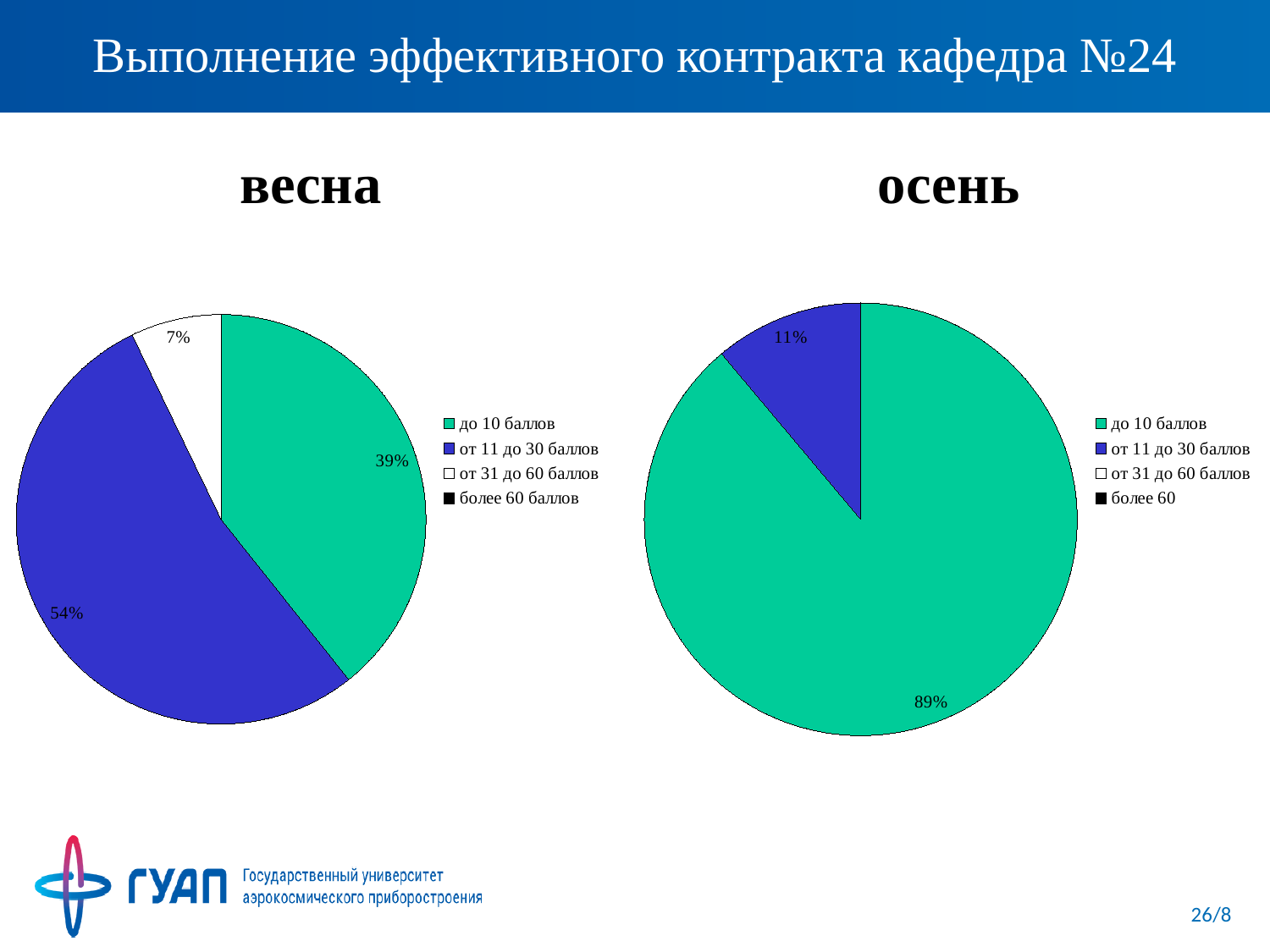
In the "весна" chart, what is the difference between the shares of "от 11 до 30 баллов" and "до 10 баллов"? 15% In the "весна" chart, which category has the largest slice? от 11 до 30 баллов In the "весна" chart, what share does "от 31 до 60 баллов" have? 7% In the "осень" chart, what share does "до 10 баллов" have? 89% In the "весна" chart, what share does "от 11 до 30 баллов" have? 54% In the "весна" chart, what share does "до 10 баллов" have? 39% How many entries does the legend of the "весна" chart list? 4 In the "осень" chart, what share does "от 11 до 30 баллов" have? 11% What type of chart is used for "весна" and "осень"? Pie chart In the "весна" chart, which labelled category has the smallest slice? от 31 до 60 баллов In the "осень" chart, which category has the largest slice? до 10 баллов In the "осень" chart, what is the difference between the shares of "до 10 баллов" and "от 11 до 30 баллов"? 78%